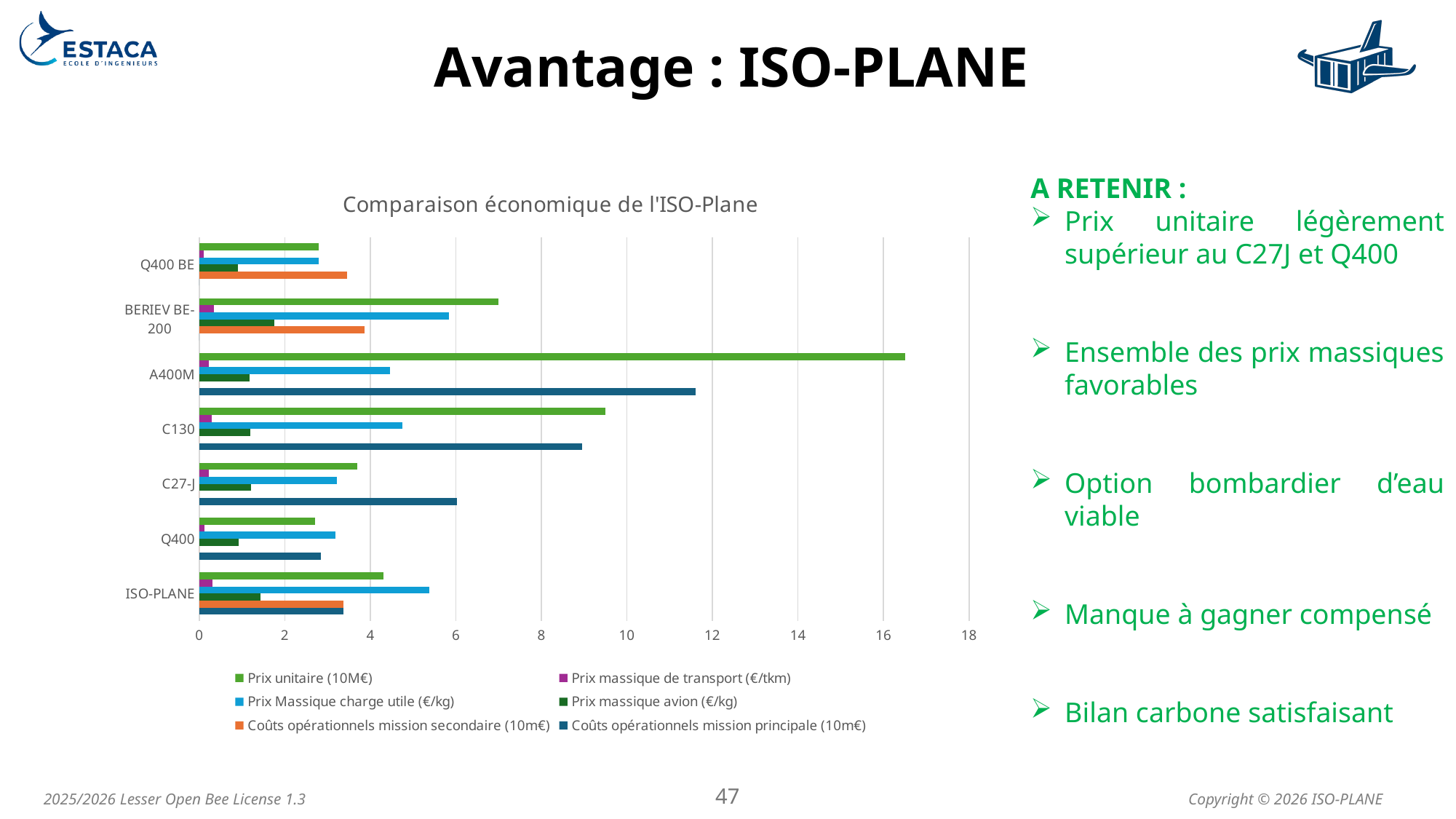
Which aircraft has the highest Coûts opérationnels mission principale (10m€)? A400M Which aircraft has the highest Prix unitaire (10M€)? A400M How many series does the chart legend list? 6 What is the title of the chart? Comparaison économique de l'ISO-Plane Is the Coûts opérationnels mission principale (10m€) value for C130 greater or less than 10? less Is the Prix Massique charge utile (€/kg) value for ISO-PLANE greater or less than 4? greater Which has the larger Prix unitaire (10M€), ISO-PLANE or C27-J? ISO-PLANE What kind of chart is shown on the slide? bar chart Is the Prix unitaire (10M€) value for A400M greater or less than 14? greater Which has the larger Coûts opérationnels mission principale (10m€), C27-J or Q400? C27-J How many aircraft categories are shown on the chart? 7